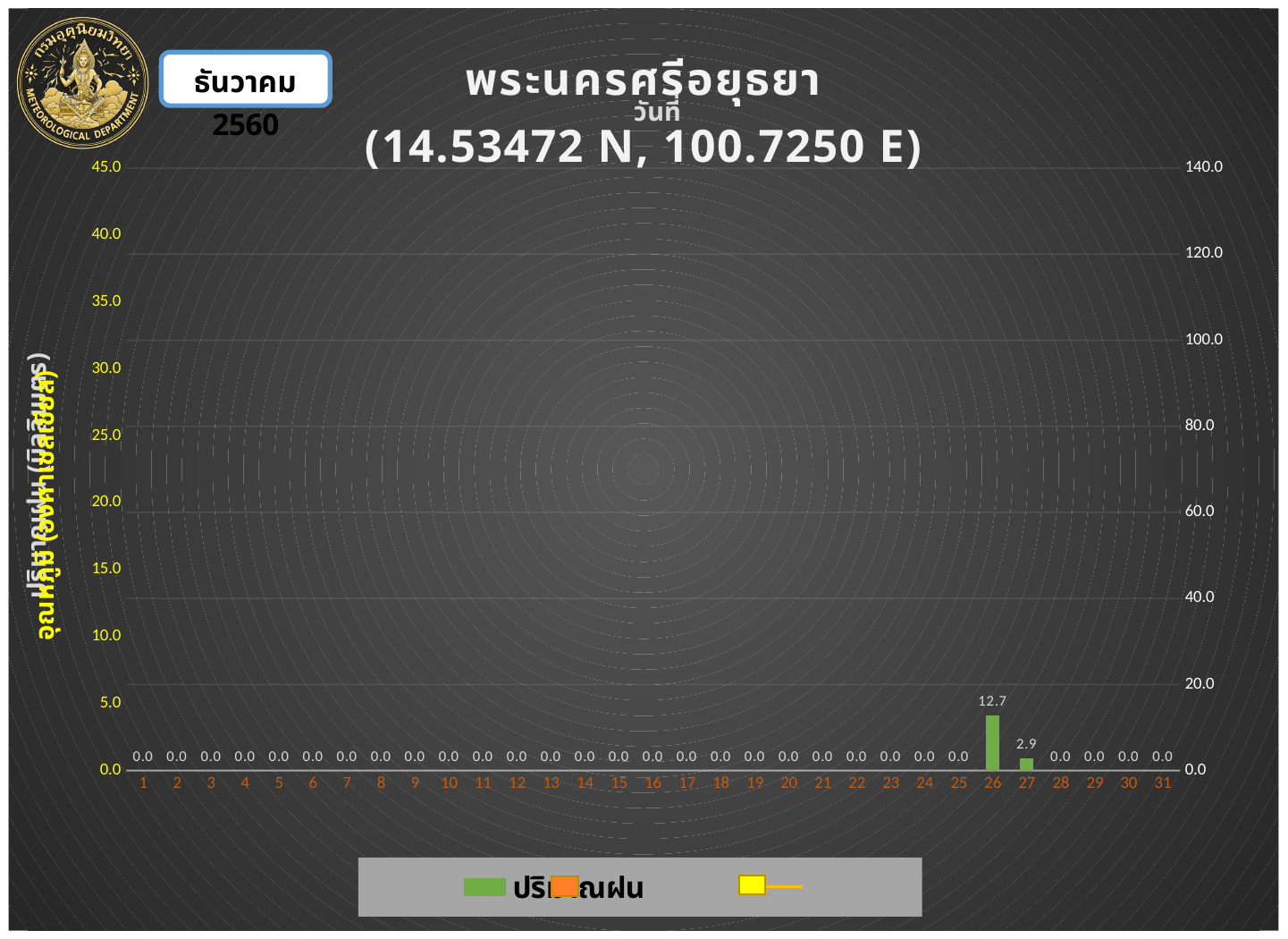
Which day has the highest rainfall value? 26 What is the highest tick value on the right-hand axis? 140.0 How many days are shown on the x axis? 31 What is the difference between the rainfall values for day 26 and day 27? 9.8 How many days have a rainfall value greater than 0.0? 2 Which day has the larger rainfall value, day 26 or day 27? 26 What is the highest tick value on the left-hand axis? 45.0 What is the rainfall value shown for day 27? 2.9 What is the rainfall value shown for day 15? 0.0 What is the rainfall value shown for day 31? 0.0 What is the rainfall value shown for day 26? 12.7 What kind of chart is this? bar chart